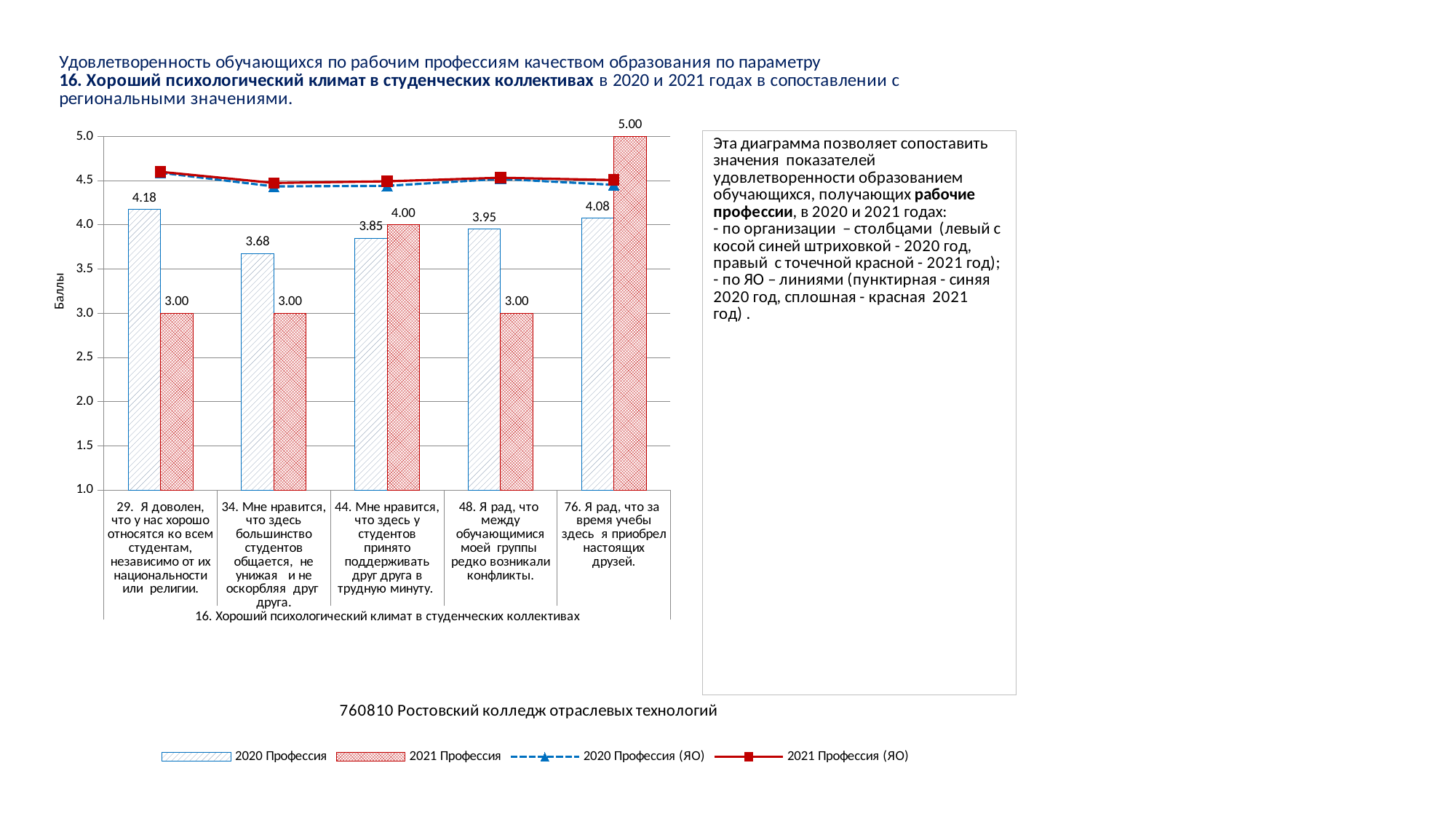
Is the 2020 Профессия (ЯО) line value for category "29. Я доволен, что у нас хорошо относятся ко всем студентам, независимо от их национальности или религии." greater or less than 4.5? greater What is the difference between the 2020 Профессия and 2021 Профессия bars for category "48. Я рад, что между обучающимися моей группы редко возникали конфликты."? 0.95 For category "44. Мне нравится, что здесь у студентов принято поддерживать друг друга в трудную минуту.", which bar is larger: 2020 Профессия or 2021 Профессия? 2021 Профессия How many series does the chart legend list? 4 Which category has the highest 2021 Профессия bar? 76. Я рад, что за время учебы здесь я приобрел настоящих друзей. Which category has the lowest 2020 Профессия bar? 34. Мне нравится, что здесь большинство студентов общается, не унижая и не оскорбляя друг друга. How many categories are shown on the x axis of the chart? 5 What is the label of the vertical axis of the chart? Баллы What is the value of the 2021 Профессия bar for category "76. Я рад, что за время учебы здесь я приобрел настоящих друзей."? 5.00 What is the value of the 2021 Профессия bar for category "44. Мне нравится, что здесь у студентов принято поддерживать друг друга в трудную минуту."? 4.00 What is the value of the 2020 Профессия bar for category "29. Я доволен, что у нас хорошо относятся ко всем студентам, независимо от их национальности или религии."? 4.18 What kind of chart is shown on the slide? Combined bar and line chart